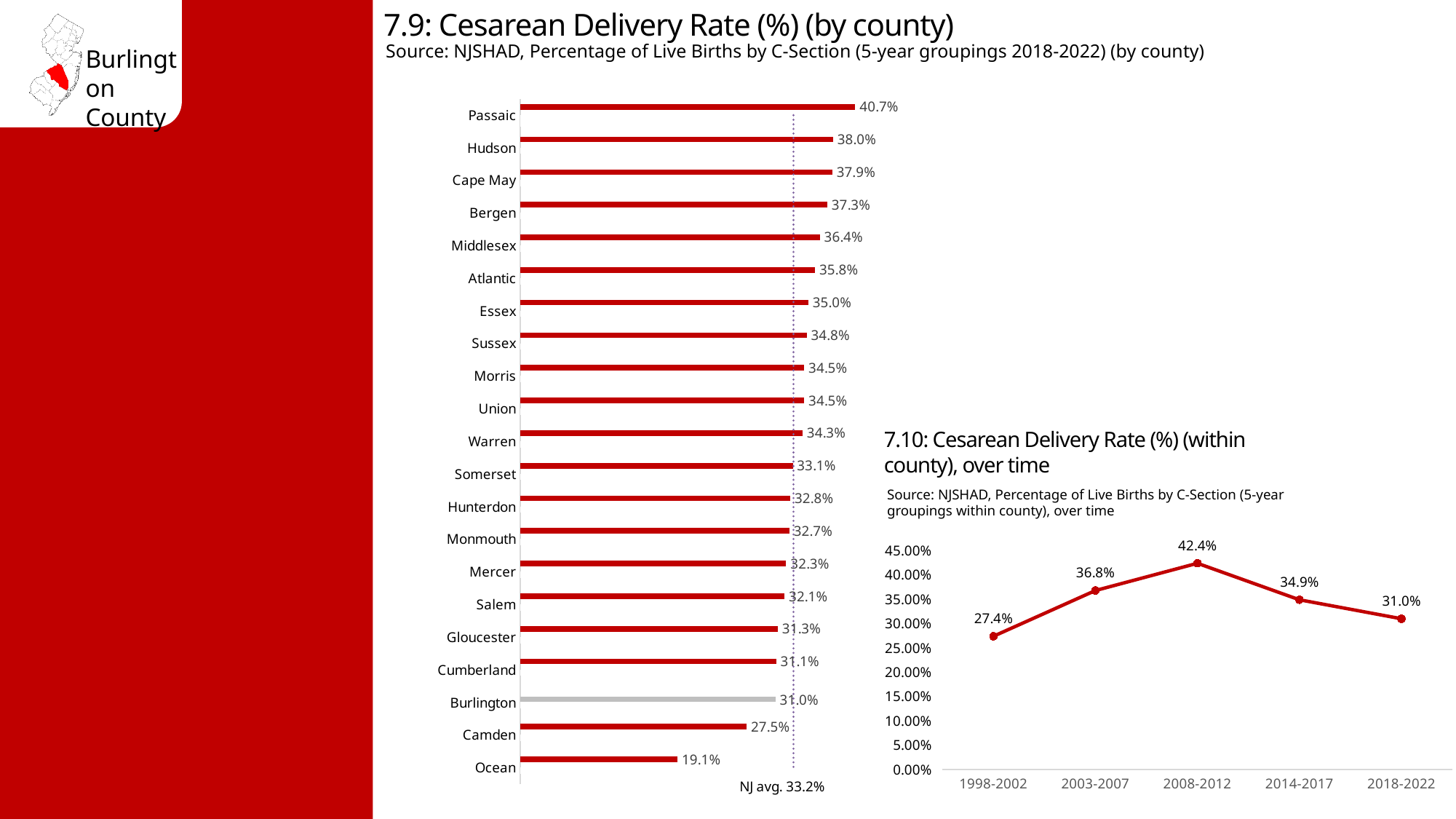
In the 7.10 Cesarean Delivery Rate over time chart, what is the difference between 2008-2012 and 2018-2022? 11.4% In the 7.9 Cesarean Delivery Rate by county chart, which is larger, Hudson or Cape May? Hudson In the 7.9 Cesarean Delivery Rate by county chart, which county has the highest rate? Passaic In the 7.9 Cesarean Delivery Rate by county chart, what is the value for Passaic? 40.7% In the 7.10 Cesarean Delivery Rate over time chart, which period has the lowest value? 1998-2002 In the 7.9 Cesarean Delivery Rate by county chart, which county has the lowest rate? Ocean In the 7.9 Cesarean Delivery Rate by county chart, what NJ average is shown by the dotted line? 33.2% What kind of chart is the 7.10 Cesarean Delivery Rate within county over time chart? line chart In the 7.9 Cesarean Delivery Rate by county chart, what is the difference between Passaic and Ocean? 21.6% In the 7.9 Cesarean Delivery Rate by county chart, what is the value for Burlington? 31.0% In the 7.9 Cesarean Delivery Rate by county chart, how many counties are shown? 21 In the 7.10 Cesarean Delivery Rate over time chart, what is the value for 2008-2012? 42.4%